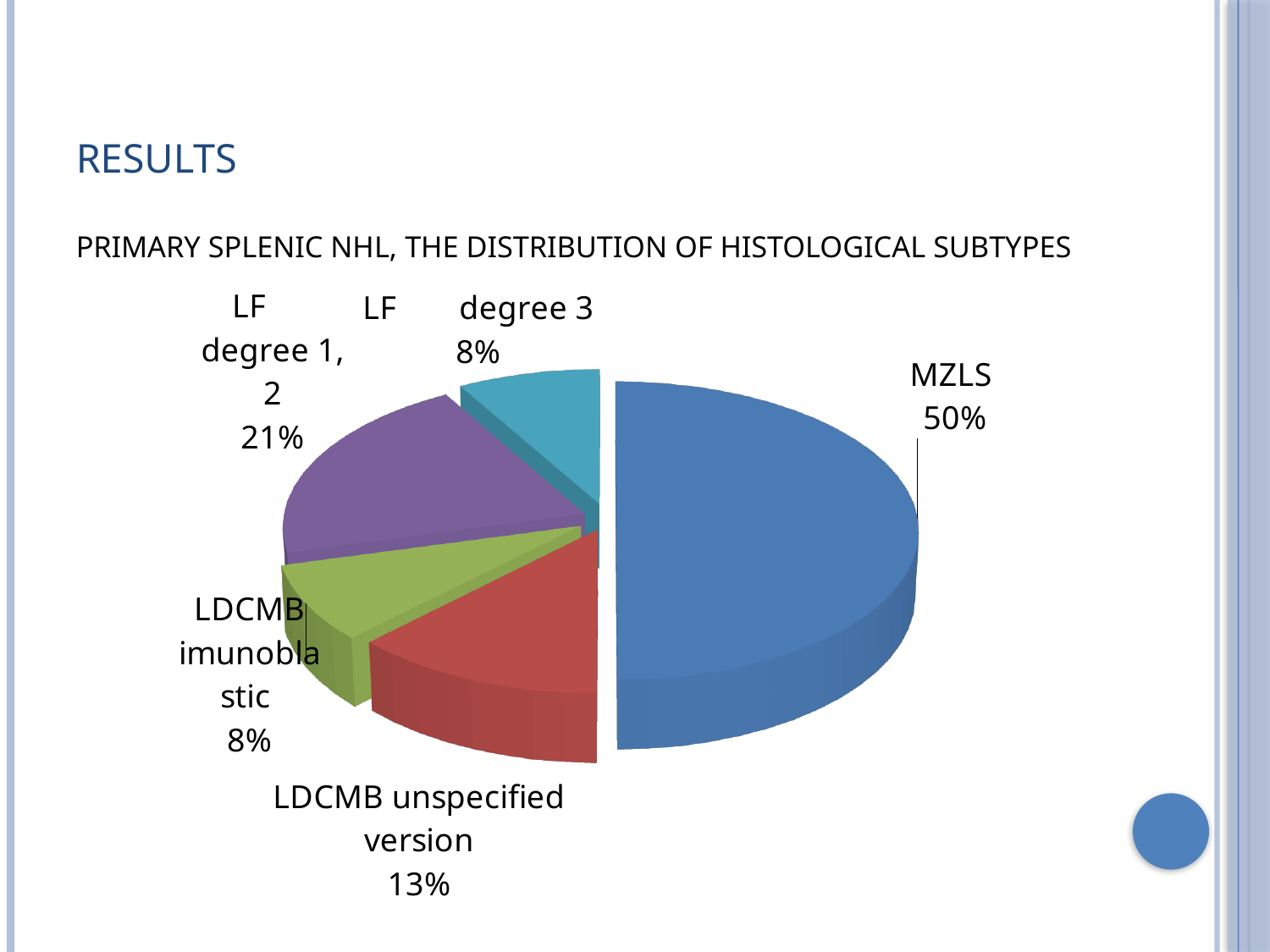
How many slices does the pie chart have? 5 What percentage is shown for LF degree 3? 8% What share of the pie does MZLS represent? 50% Which histological subtype has the largest share of the pie? MZLS What is the difference in percentage points between LF degree 1, 2 and LDCMB unspecified version? 8 Which is larger, the share for LDCMB unspecified version or the share for LF degree 3? LDCMB unspecified version What is the difference in percentage points between MZLS and LF degree 1, 2? 29 What percentage is shown for LDCMB imunoblastic? 8% What percentage is shown for LDCMB unspecified version? 13% What percentage is shown for LF degree 1, 2? 21% What kind of chart is shown on the slide? Pie chart What is the title of the chart? PRIMARY SPLENIC NHL, THE DISTRIBUTION OF HISTOLOGICAL SUBTYPES